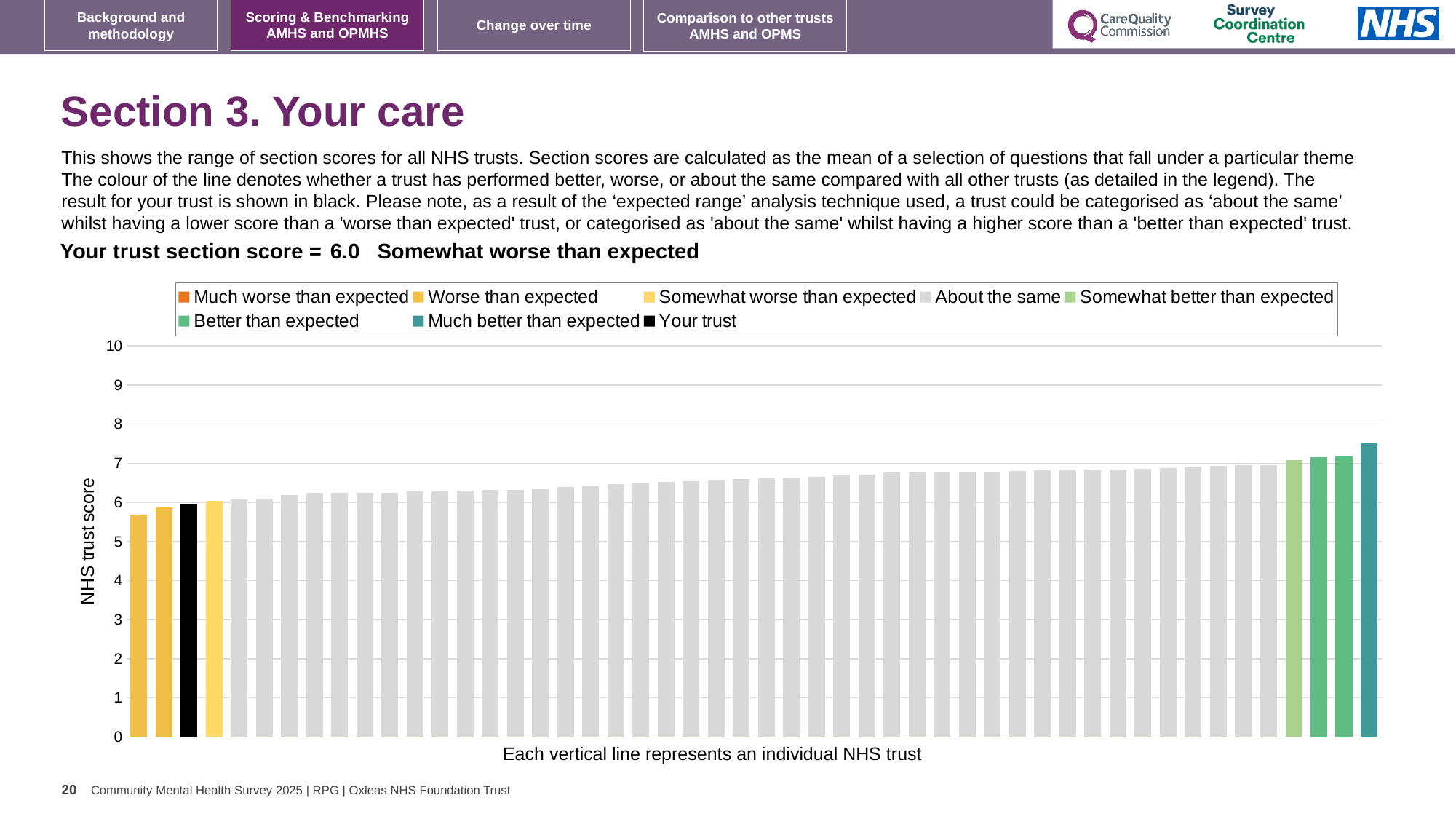
Which is larger, the rightmost bar or the leftmost bar? the rightmost bar Is the value of the leftmost bar in the chart greater or less than 6? less Which legend category does the tallest bar belong to? Much better than expected Is the value of the tallest bar in the chart greater or less than 7? greater Is the value of the black 'Your trust' bar greater or less than 7? less Which legend category is your trust placed in for Section 3? Somewhat worse than expected What is the section score for your trust shown on the slide? 6.0 Do the bar values rise or fall from left to right along the x axis? rise What kind of chart is shown on the slide? bar chart How many entries does the chart legend list? 8 What is the label on the vertical axis of the chart? NHS trust score Which legend category does the shortest bar belong to? Worse than expected